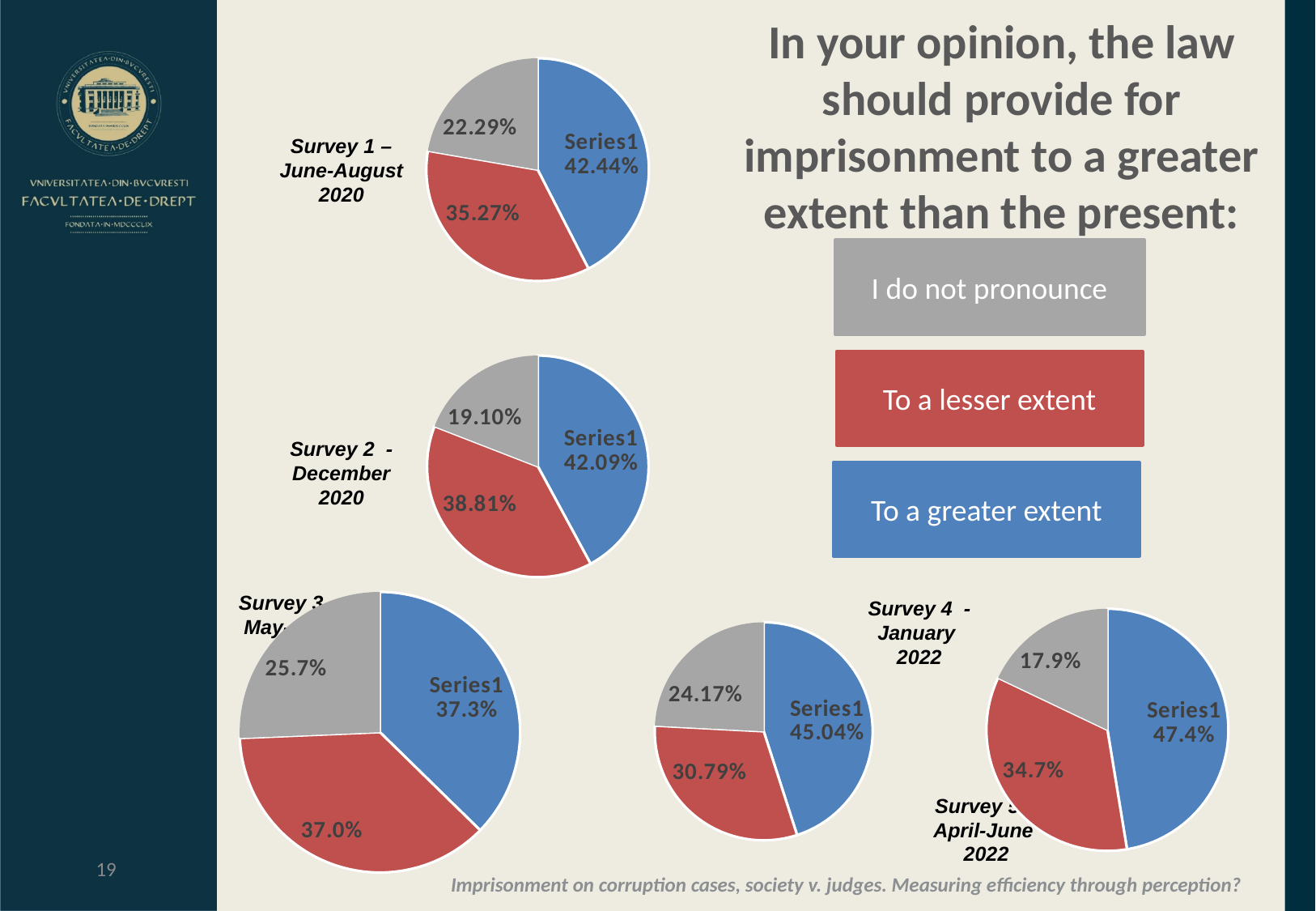
In the Survey 2 - December 2020 pie chart, what is the difference between the "To a greater extent" and "To a lesser extent" shares? 3.28% How many pie charts are shown on the slide? 5 Which is larger: the "To a greater extent" share in Survey 1 – June-August 2020 or in Survey 4 - January 2022? Survey 4 - January 2022 In the Survey 1 – June-August 2020 pie chart, what share of respondents chose "To a greater extent"? 42.44% In the Survey 4 - January 2022 pie chart, which response has the largest share? To a greater extent In the Survey 3 pie chart (bottom left), what percentage is shown for "I do not pronounce"? 25.7% In the Survey 2 - December 2020 pie chart, what percentage is shown for "To a lesser extent"? 38.81% In the Survey 1 – June-August 2020 pie chart, which response has the smallest share? I do not pronounce In the April-June 2022 pie chart (bottom right), what share of respondents chose "To a greater extent"? 47.4% In the April-June 2022 pie chart (bottom right), what is the difference between the "To a lesser extent" and "I do not pronounce" shares? 16.8% What colour represents "To a lesser extent" in the pie charts? Red In the Survey 4 - January 2022 pie chart, what percentage is shown for "I do not pronounce"? 24.17%